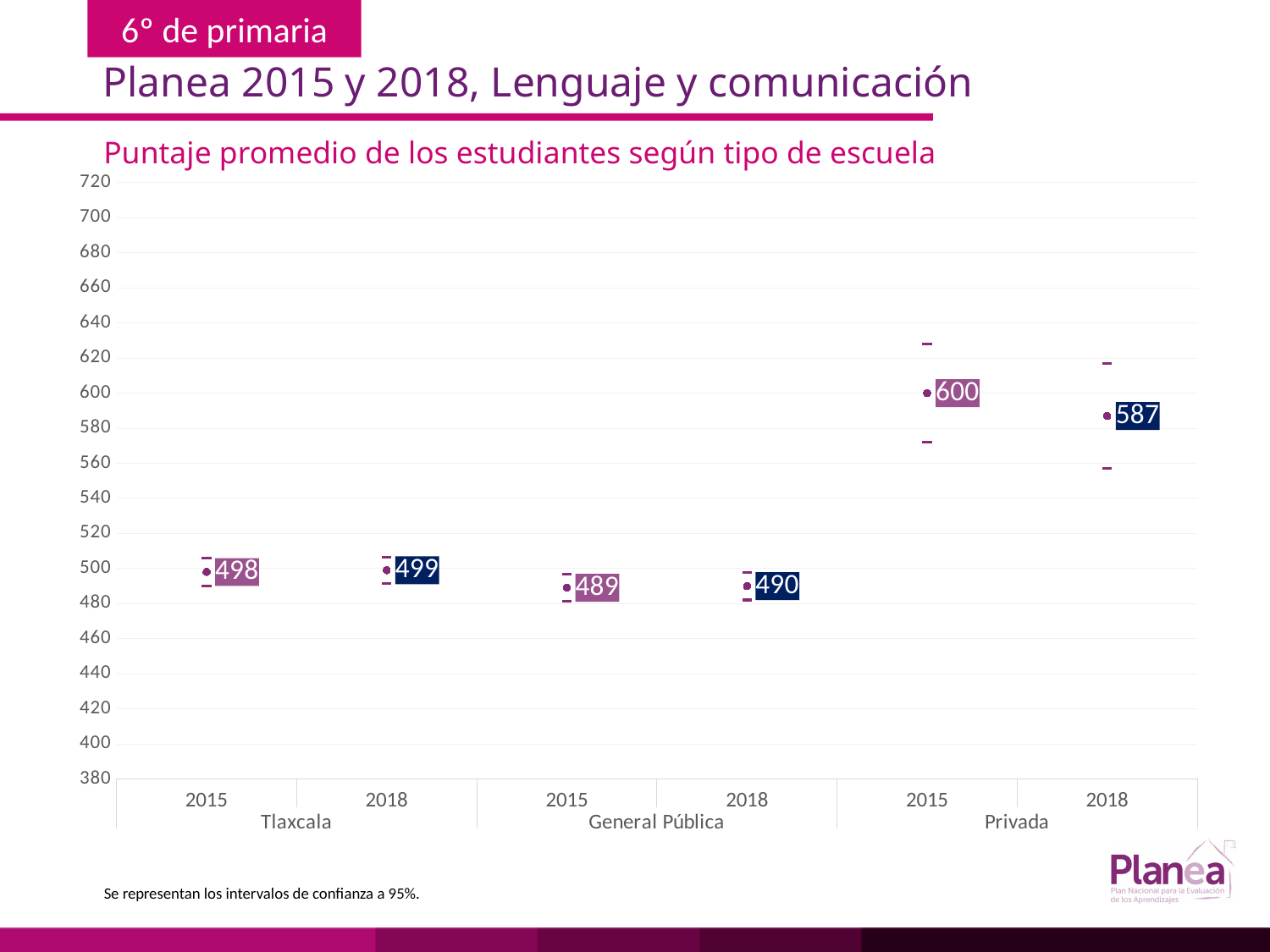
What is the difference between the Tlaxcala score and the General Pública score in 2018? 9 What is the title of the chart? Puntaje promedio de los estudiantes según tipo de escuela What is the average score for Privada in 2015? 600 What is the difference between the Privada scores in 2015 and 2018? 13 Which school type and year has the lowest average score? General Pública 2015 Which is larger, the Privada score in 2018 or the Tlaxcala score in 2018? Privada 2018 What is the average score for Privada in 2018? 587 Which school type and year has the highest average score? Privada 2015 What is the average score for Tlaxcala in 2015? 498 Did the Privada average score rise or fall from 2015 to 2018? fall What is the average score for General Pública in 2018? 490 How many data points are plotted on the chart? 6